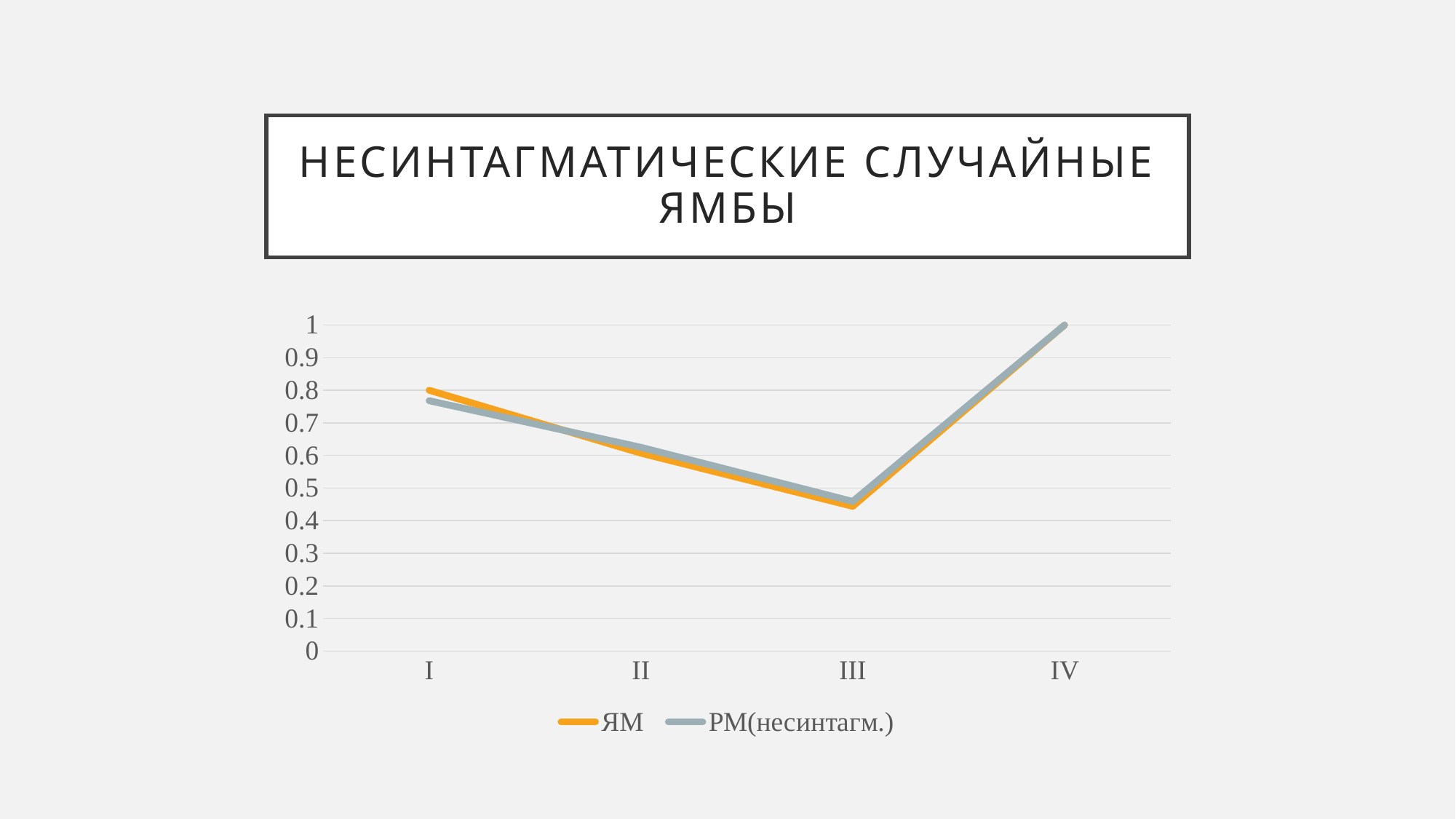
Which colour is used for the ЯМ series line? orange Is the value of the ЯМ series at category III greater or less than 0.5? less At which category does the ЯМ series reach its lowest value? III How many series does the legend list? 2 At which category does the ЯМ series reach its highest value? IV What kind of chart is shown on the slide? line chart At which category does the РМ(несинтагм.) series reach its lowest value? III How many categories are shown on the x axis? 4 What is the value of the ЯМ series at category IV? 1 What is the value of the РМ(несинтагм.) series at category IV? 1 Is the value of the РМ(несинтагм.) series at category I greater or less than 0.7? greater Do the values of the ЯМ series rise or fall from category I to category III? fall